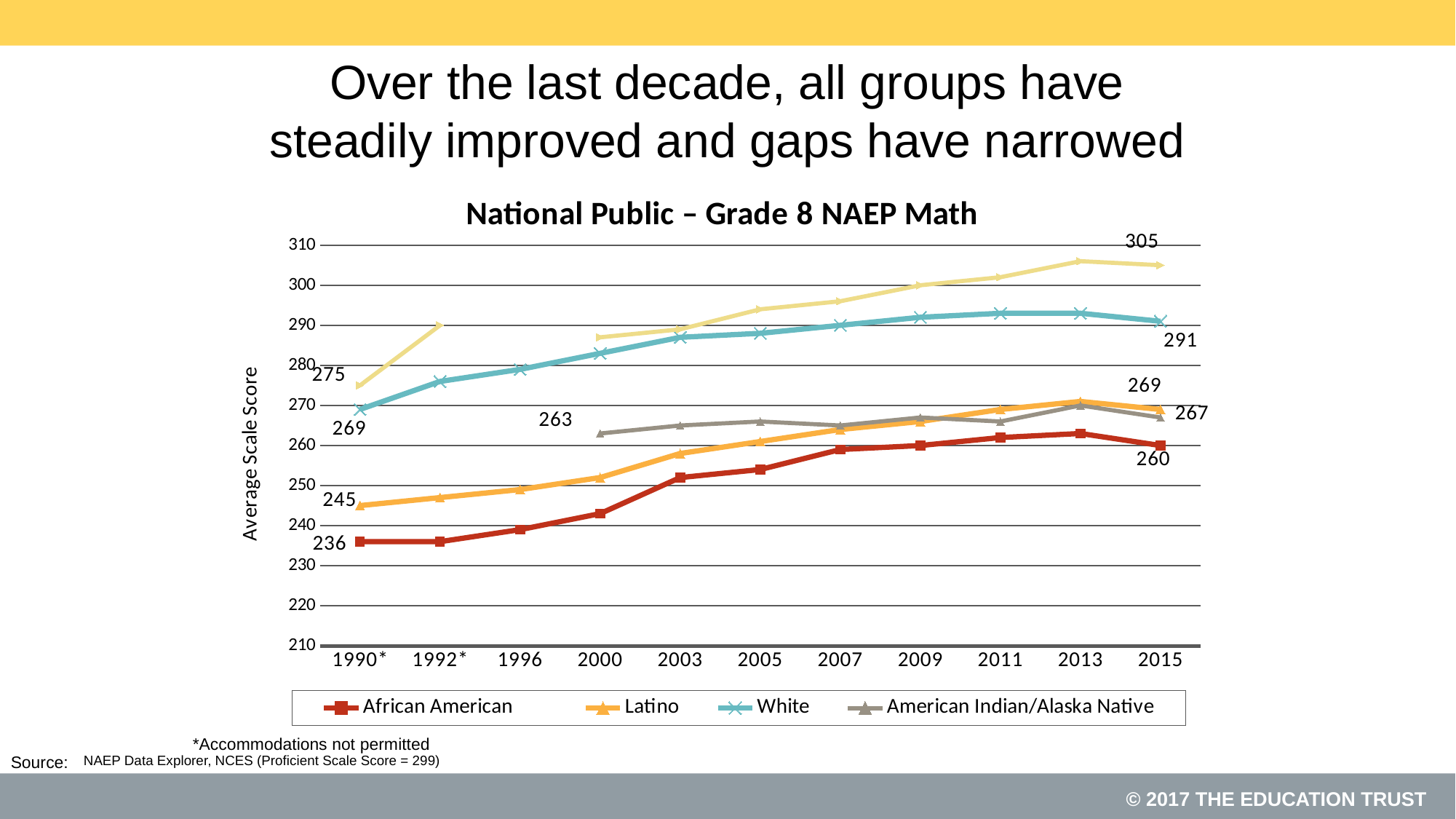
Does the African American line rise or fall from 1990 to 2015? rise What is the difference between the 2015 scores of White students and African American students? 31 How many series does the legend list? 4 Is the value for African American students in 2007 greater or less than 250? greater How many years are shown on the x axis? 11 What was the average scale score for American Indian/Alaska Native students in 2000? 263 What kind of chart is shown on the slide? line chart What was the average scale score for Latino students in 2015? 269 What was the average scale score for White students in 2015? 291 What was the average scale score for African American students in 1990? 236 In 2015, which group scored higher: Latino or American Indian/Alaska Native? Latino By how many points did the African American score increase from 1990 to 2015? 24